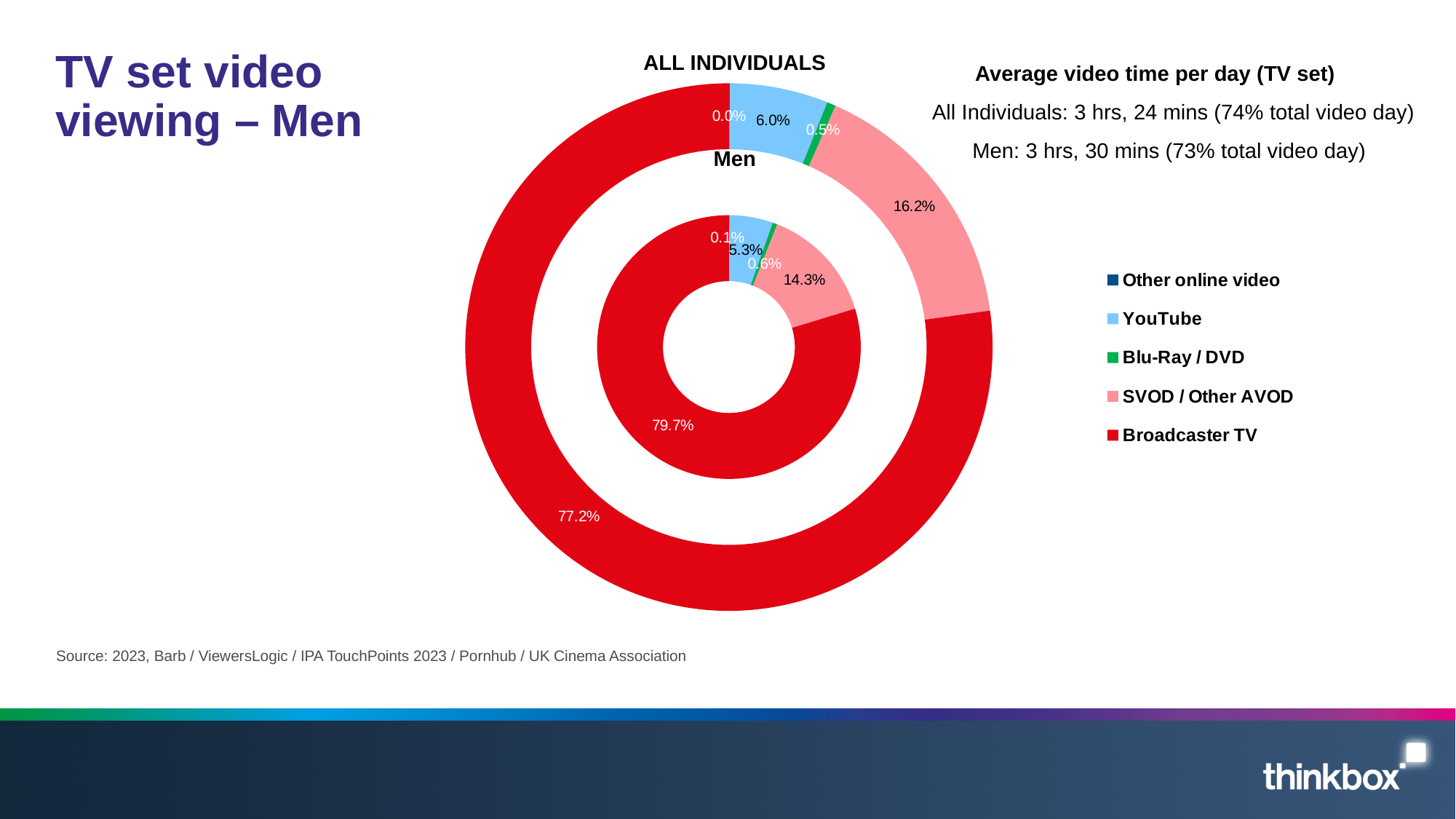
Is the SVOD / Other AVOD share larger for All Individuals or for Men? All Individuals Which category has the smallest share in the All Individuals ring? Other online video How many categories does the legend list? 5 What share of TV set video viewing for Men is Broadcaster TV? 79.7% What is the difference between the Broadcaster TV share for Men and for All Individuals? 2.5% What is the Blu-Ray / DVD share for All Individuals? 0.5% What type of chart is shown on the slide? Doughnut chart What is the SVOD / Other AVOD share for Men? 14.3% What is the YouTube share for All Individuals? 6.0% What is the Other online video share for Men? 0.1% What share of TV set video viewing for All Individuals is Broadcaster TV? 77.2% Which category has the largest share in the Men ring? Broadcaster TV